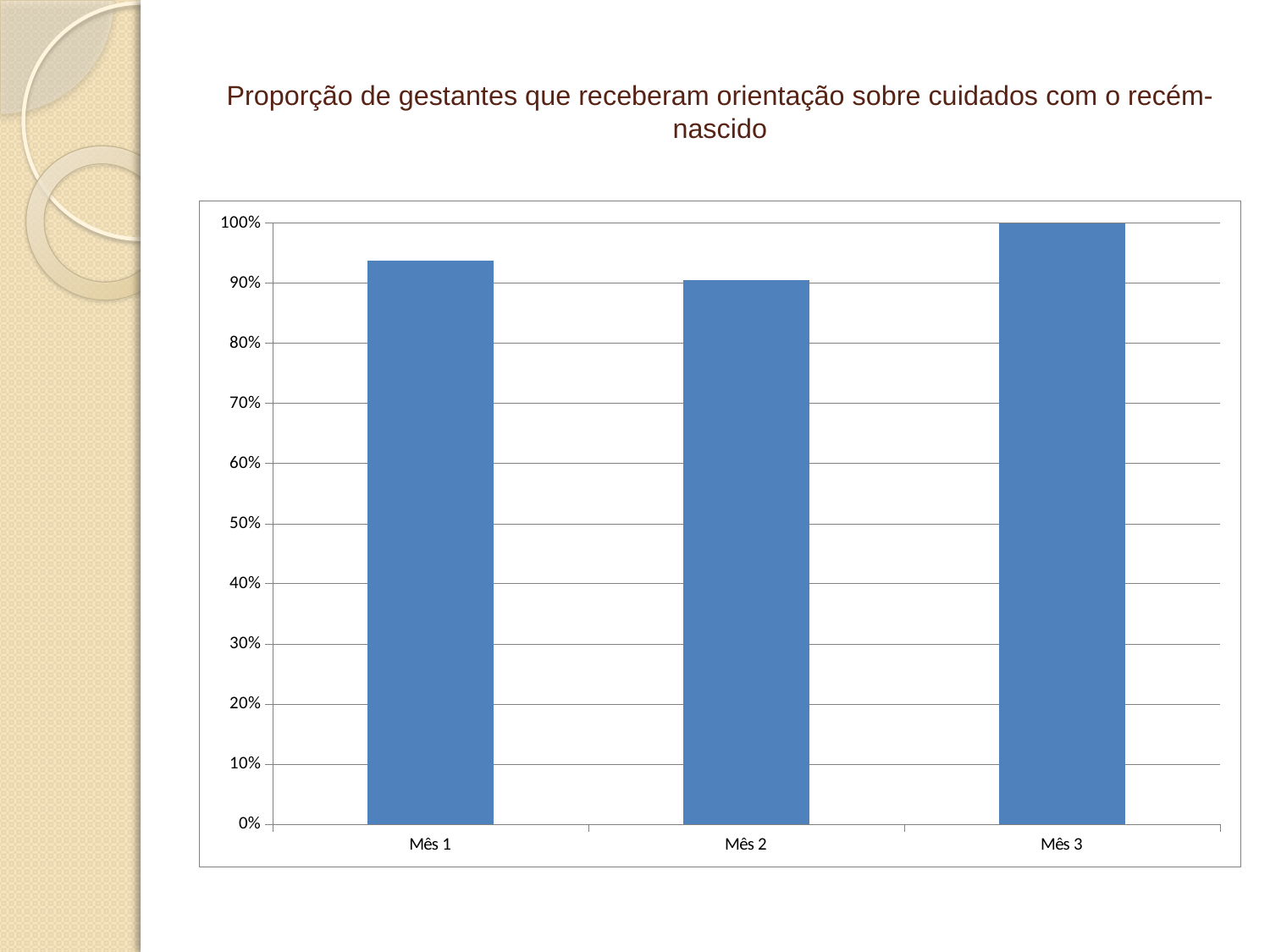
What is the title of the chart on the slide? Proporção de gestantes que receberam orientação sobre cuidados com o recém-nascido Which month has the highest proportion? Mês 3 What is the value for Mês 3? 100% Does the value rise or fall from Mês 1 to Mês 2? fall Which is larger, the value for Mês 1 or the value for Mês 2? Mês 1 Is the value for Mês 1 greater or less than 90%? greater What kind of chart is shown on the slide? Bar chart Is the value for Mês 1 greater or less than 100%? less Does the value rise or fall from Mês 2 to Mês 3? rise How many categories (months) are plotted on the chart? 3 Is the value for Mês 2 greater or less than 80%? greater Which month has the lowest proportion? Mês 2